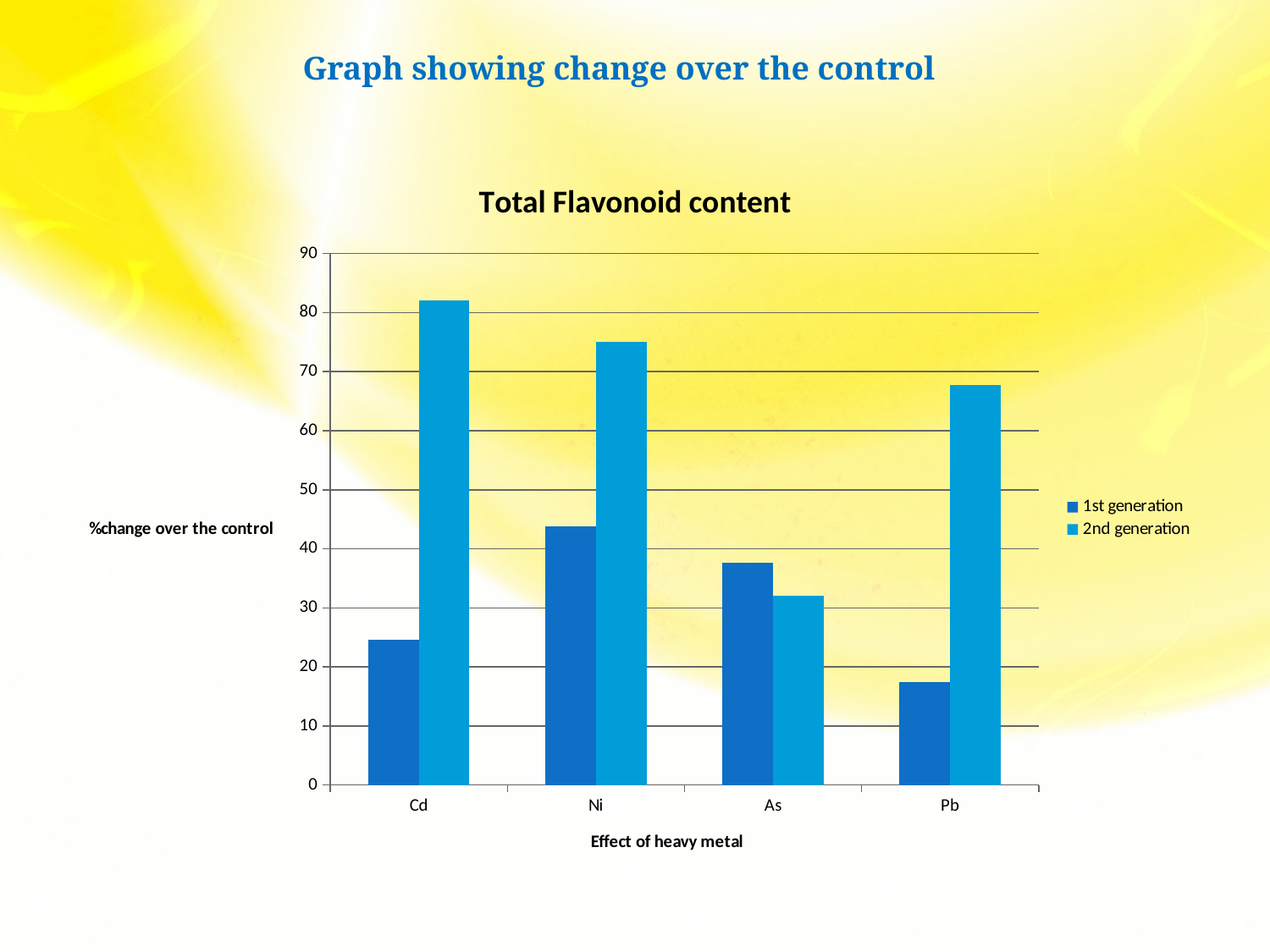
For As, which is larger: the 1st generation or the 2nd generation value? 1st generation Is the 2nd generation value for Cd greater or less than 80? greater What is the label of the x axis? Effect of heavy metal Which heavy metal has the lowest 1st generation value? Pb How many heavy metal categories are shown on the x axis? 4 Which heavy metal has the highest 2nd generation value? Cd Which heavy metal has the lowest 2nd generation value? As Which heavy metal has the highest 1st generation value? Ni Is the 1st generation value for Pb greater or less than 20? less What is the title of the chart? Total Flavonoid content How many series does the legend list? 2 What kind of chart is shown on the slide? bar chart